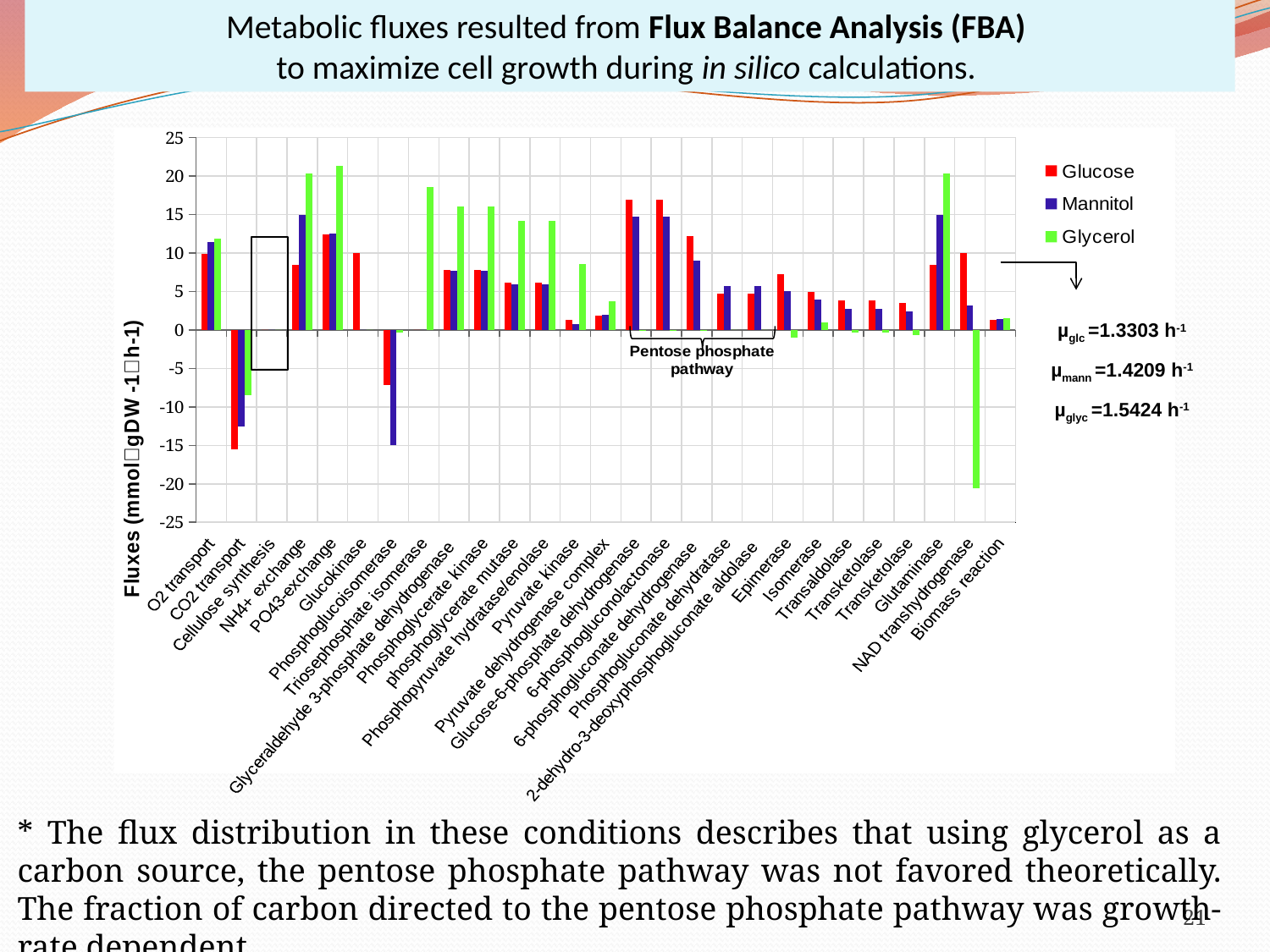
How many reaction categories are shown along the x axis? 27 Which series has the lowest value for NAD transhydrogenase? Glycerol Which series has the highest value for PO43-exchange? Glycerol Is the Glycerol value for NAD transhydrogenase greater or less than -15? less Is the Glycerol value for Triosephosphate isomerase greater or less than 15? greater Is the Mannitol value for Phosphoglucoisomerase greater or less than -10? less How many series does the legend list? 3 For Glucose-6-phosphate dehydrogenase, which is larger: the Glucose value or the Glycerol value? Glucose What kind of chart is shown on the slide? bar chart Which series are listed in the legend? Glucose, Mannitol, Glycerol